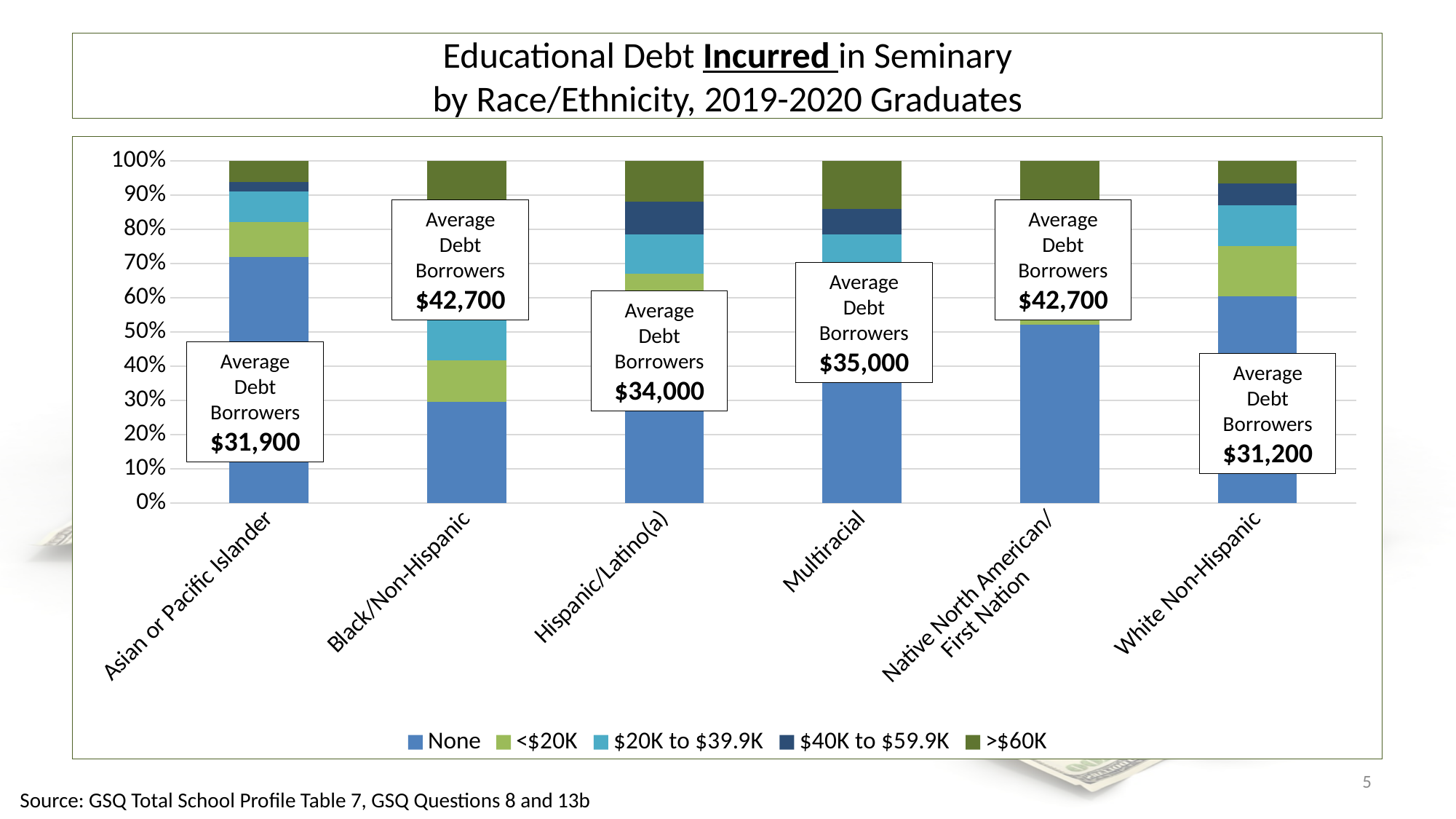
How many race/ethnicity categories are shown on the x axis? 6 Which group has a higher average debt for borrowers, Multiracial or Asian or Pacific Islander? Multiracial What is the average debt for borrowers among Black/Non-Hispanic graduates? $42,700 What is the average debt for borrowers among White Non-Hispanic graduates? $31,200 What kind of chart is shown on the slide? Stacked bar chart What is the average debt for borrowers among Multiracial graduates? $35,000 Is the share of Asian or Pacific Islander graduates with no debt (None) greater or less than 60%? greater What is the average debt for borrowers among Hispanic/Latino(a) graduates? $34,000 Is the share of Black/Non-Hispanic graduates with no debt (None) greater or less than 40%? less What is the difference between the average debt for borrowers of Black/Non-Hispanic graduates and White Non-Hispanic graduates? $11,500 How many debt-level series does the legend list? 5 Which race/ethnicity group has the lowest average debt for borrowers? White Non-Hispanic